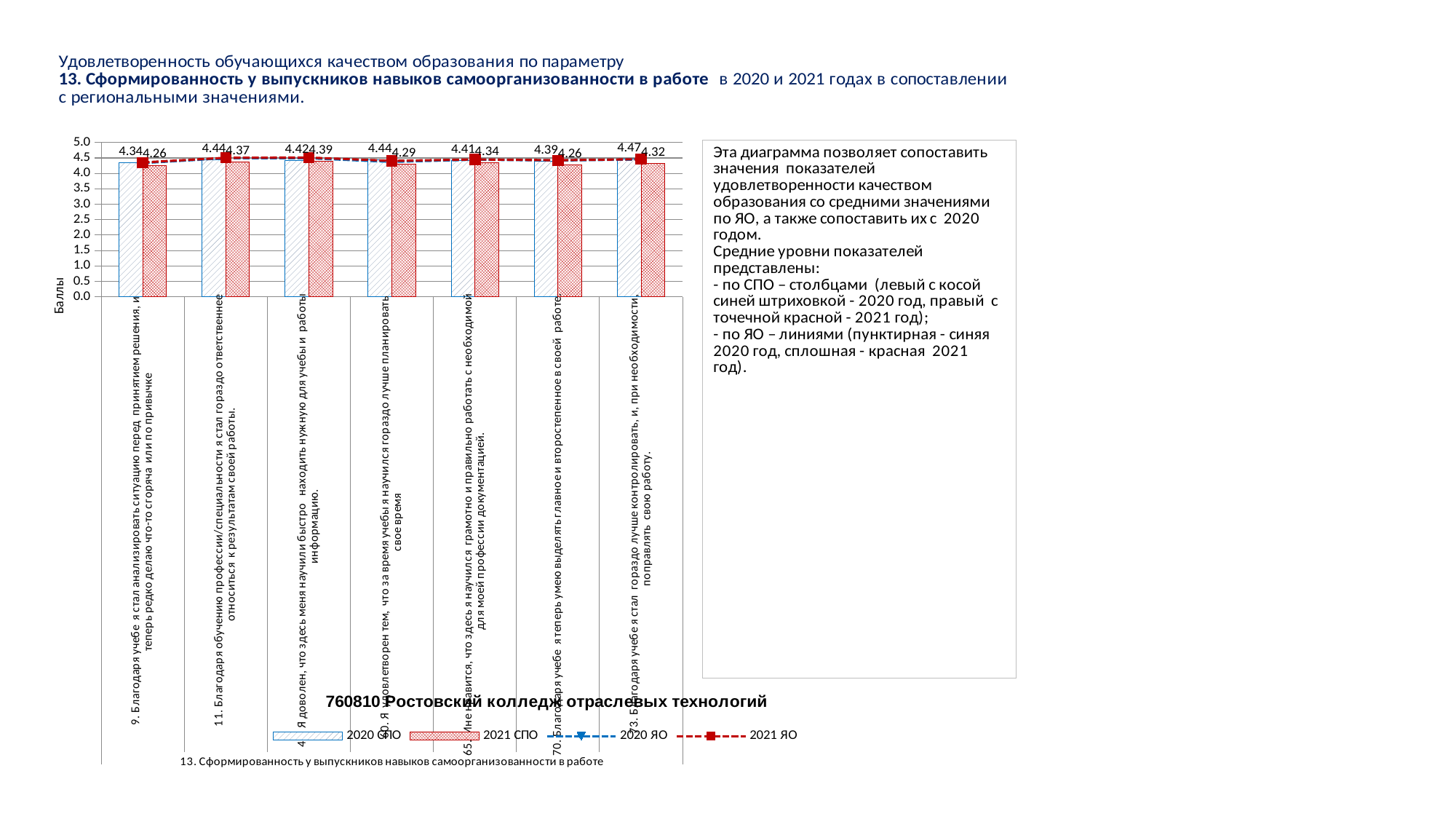
What is the difference between the two values printed for the seventh category (4.47 and 4.32)? 0.15 How many categories are plotted along the x axis of the chart? 7 How many series does the chart legend list? 4 What are the two values printed above the bars for the second category (11. Благодаря обучению профессии/специальности...)? 4.44 and 4.37 What is the higher of the two values printed for the seventh (last) category? 4.47 Among the first (left) values printed for each category, which category has the highest value? The seventh (last) category, 4.47 What kind of chart is shown on the slide? A combined bar and line chart What are the two values printed above the bars for the first category (9. Благодаря учебе я стал анализировать ситуацию...)? 4.34 and 4.26 What is the difference between the two values printed for the first category (4.34 and 4.26)? 0.08 Among the second (right) values printed for each category, which category has the highest value? The third category, 4.39 What is the label of the vertical axis of the chart? Баллы Is the value for the 2021 СПО bar in the first category greater or less than 4.0? greater